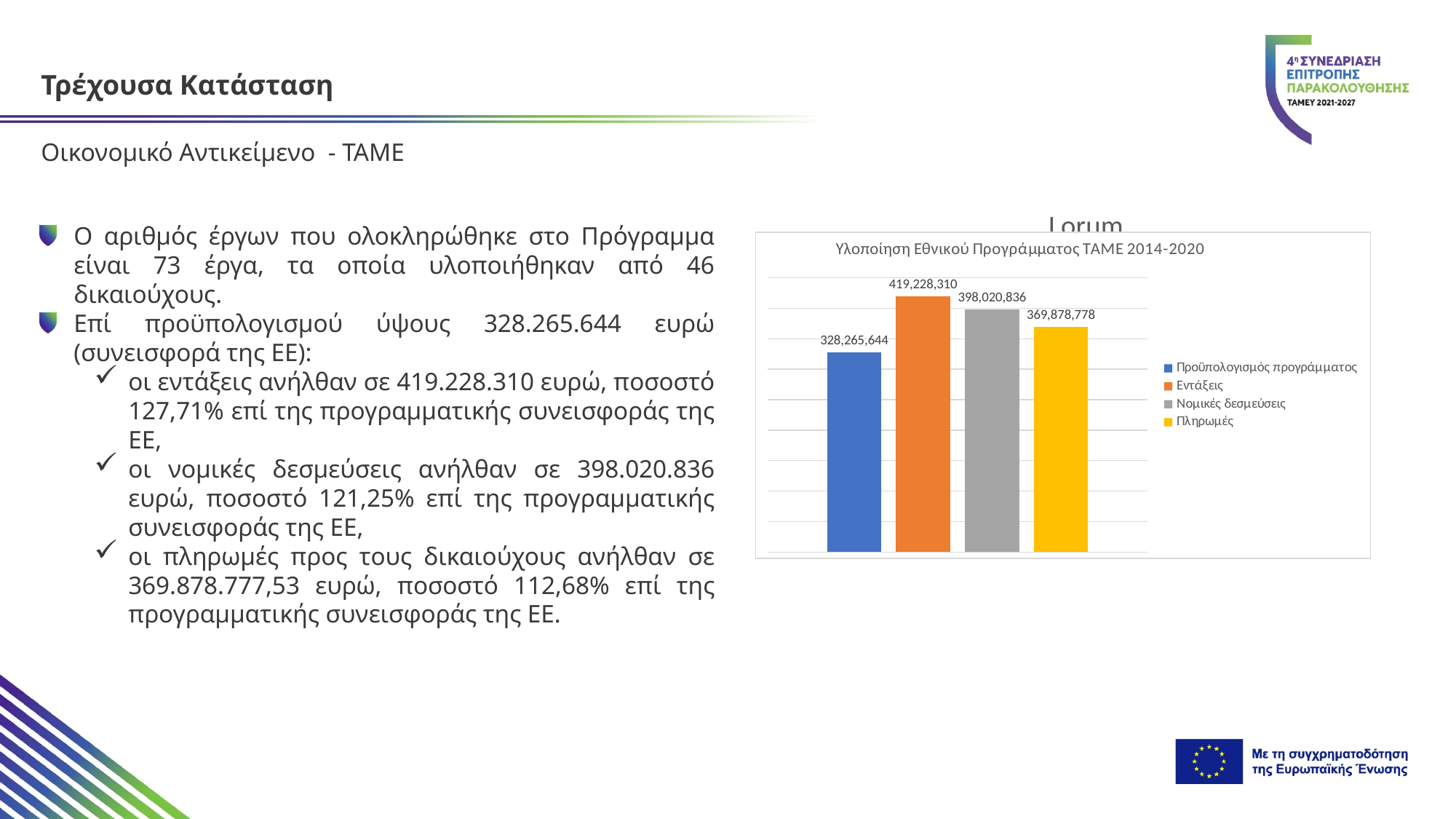
What is the value shown for Πληρωμές? 369,878,778 What is the difference between the values for Νομικές δεσμεύσεις and Πληρωμές? 28,142,058 Which series has the lowest value in the chart? Προϋπολογισμός προγράμματος What is the value shown for Εντάξεις? 419,228,310 Which series has the highest value in the chart? Εντάξεις What type of chart is shown on the slide? Bar chart What is the value shown for Νομικές δεσμεύσεις? 398,020,836 What is the title of the chart? Υλοποίηση Εθνικού Προγράμματος ΤΑΜΕ 2014-2020 What is the difference between the values for Εντάξεις and Προϋπολογισμός προγράμματος? 90,962,666 How many series does the chart legend list? 4 Which is larger, the value for Νομικές δεσμεύσεις or the value for Πληρωμές? Νομικές δεσμεύσεις What is the value shown for Προϋπολογισμός προγράμματος? 328,265,644